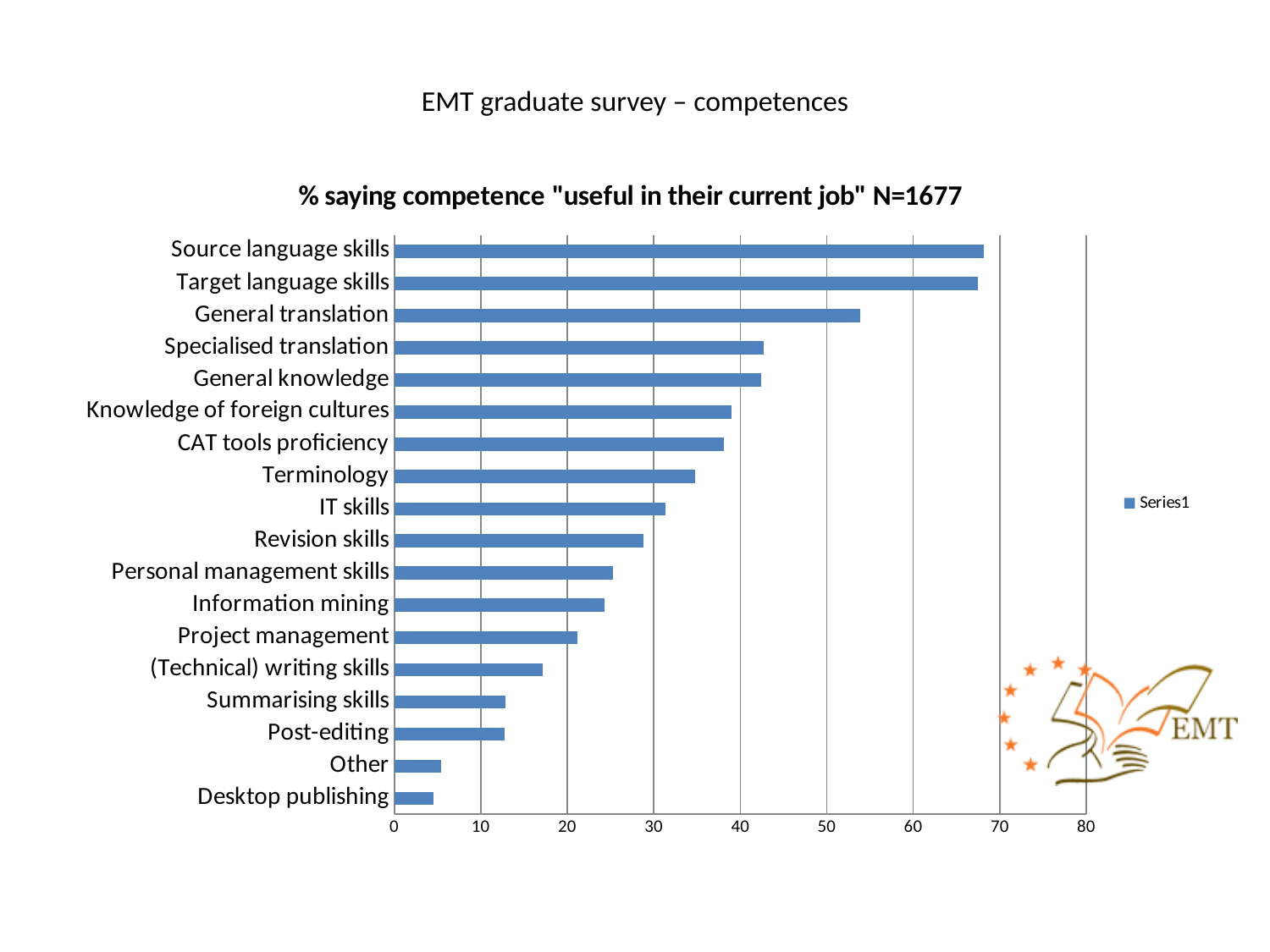
What is the title of the chart? % saying competence "useful in their current job" N=1677 Is the value for Specialised translation greater or less than 40? greater Is the value for (Technical) writing skills greater or less than 20? less Is the value for Desktop publishing greater or less than 10? less How many series does the legend list? 1 How many competences are listed on the chart? 18 Do the bar values rise or fall going from the top of the chart to the bottom? fall Which has a higher value, General translation or Specialised translation? General translation Which has a higher value, Terminology or IT skills? Terminology What kind of chart is shown on the slide? bar chart